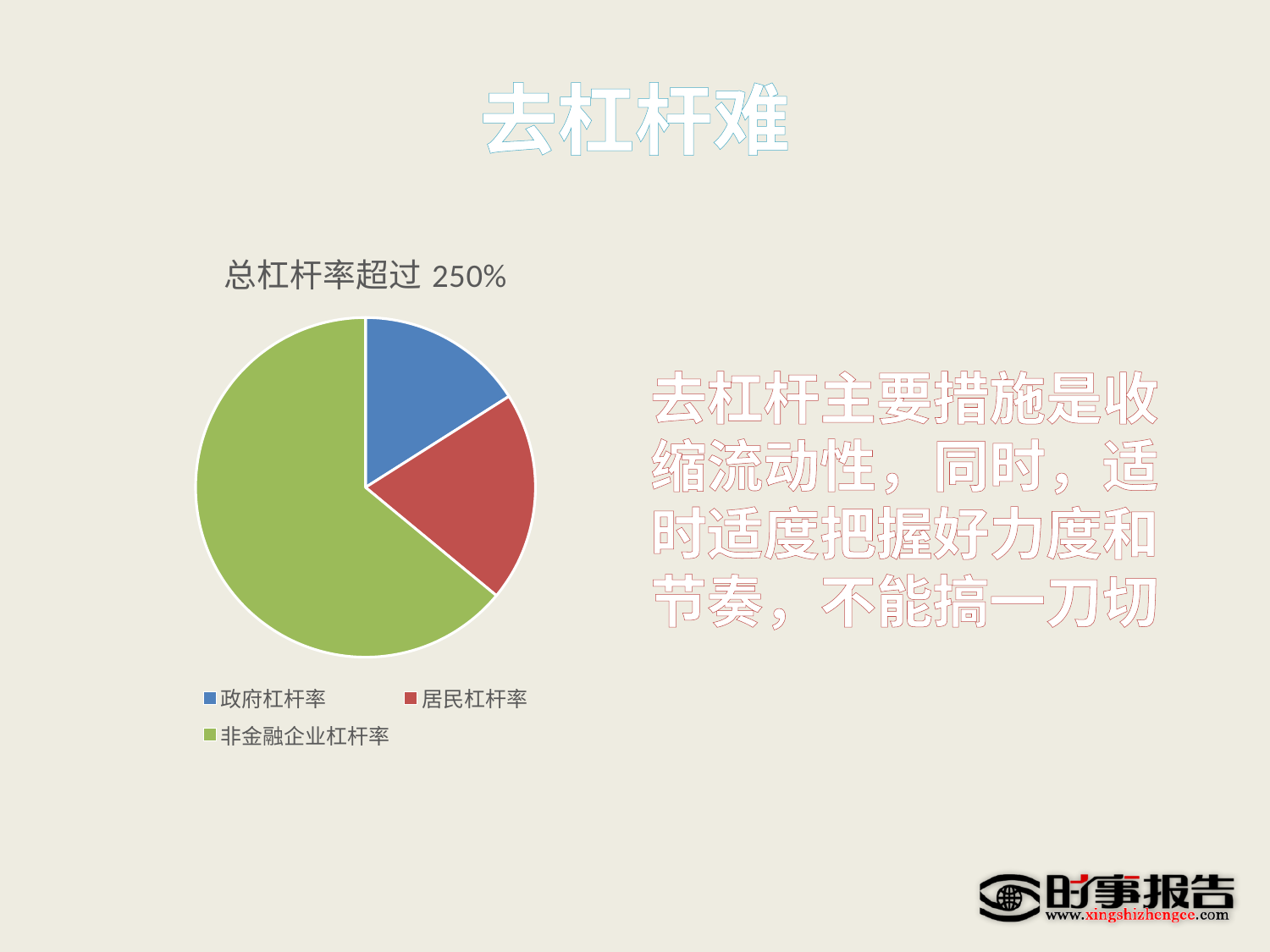
Which slice is larger, 非金融企业杠杆率 or 政府杠杆率? 非金融企业杠杆率 Which colour represents 非金融企业杠杆率 in the pie chart? green What kind of chart is shown on the slide? pie chart How many slices does the pie chart have? 3 How many entries does the legend of the pie chart list? 3 What is the title of the pie chart? 总杠杆率超过 250% Which slice is larger, 非金融企业杠杆率 or 居民杠杆率? 非金融企业杠杆率 Which category has the largest slice in the pie chart? 非金融企业杠杆率